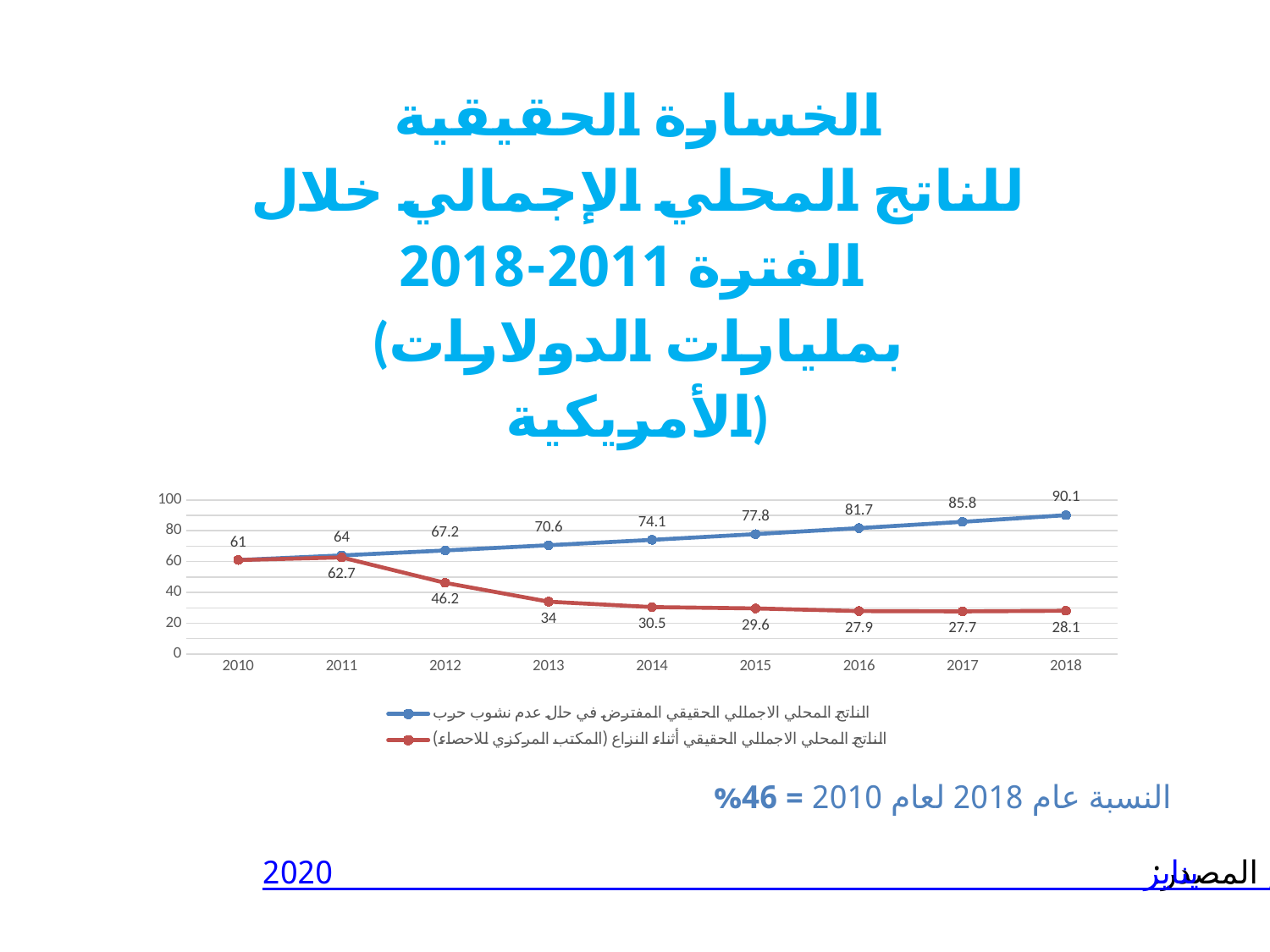
In which year does the blue line (hypothetical real GDP without war) reach its highest value? 2018 How many series does the chart legend list? 2 What type of chart is shown on the slide? Line chart What is the value of the red line (actual real GDP during the conflict) in 2013? 34 What is the difference between the blue line and the red line values in 2018? 62 How many years are plotted along the x axis of the chart? 9 Does the red line (actual real GDP during the conflict) generally rise or fall from 2011 to 2017? Fall What colour is the line for the hypothetical real GDP without war? Blue What is the value of the blue line (hypothetical real GDP without war) in 2018? 90.1 Which series has the larger value in 2012, the blue line or the red line? The blue line What is the value of the red line (actual real GDP during the conflict) in 2011? 62.7 In which year does the red line (actual real GDP during the conflict) reach its lowest value? 2017